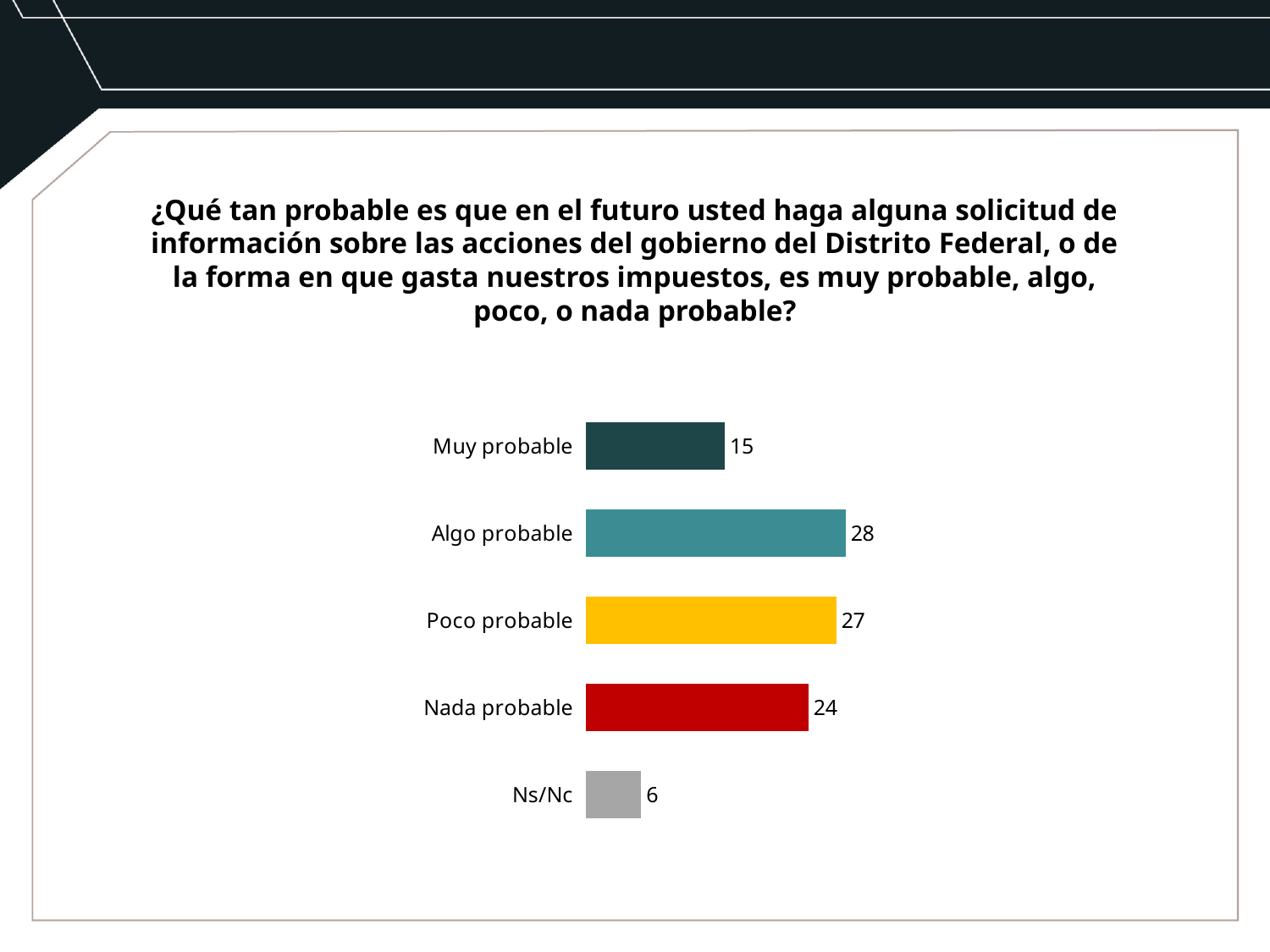
What is the difference between the values for "Poco probable" and "Nada probable"? 3 What is the value for "Muy probable"? 15 Which category has the lowest value? Ns/Nc Which is larger, the value for "Muy probable" or the value for "Nada probable"? Nada probable What kind of chart is shown on the slide? Bar chart Which category has the highest value? Algo probable What is the value for "Ns/Nc"? 6 What is the difference between the values for "Algo probable" and "Muy probable"? 13 What colour is the bar for "Poco probable"? Yellow What is the value for "Algo probable"? 28 How many categories are shown in the chart? 5 What is the value for "Nada probable"? 24